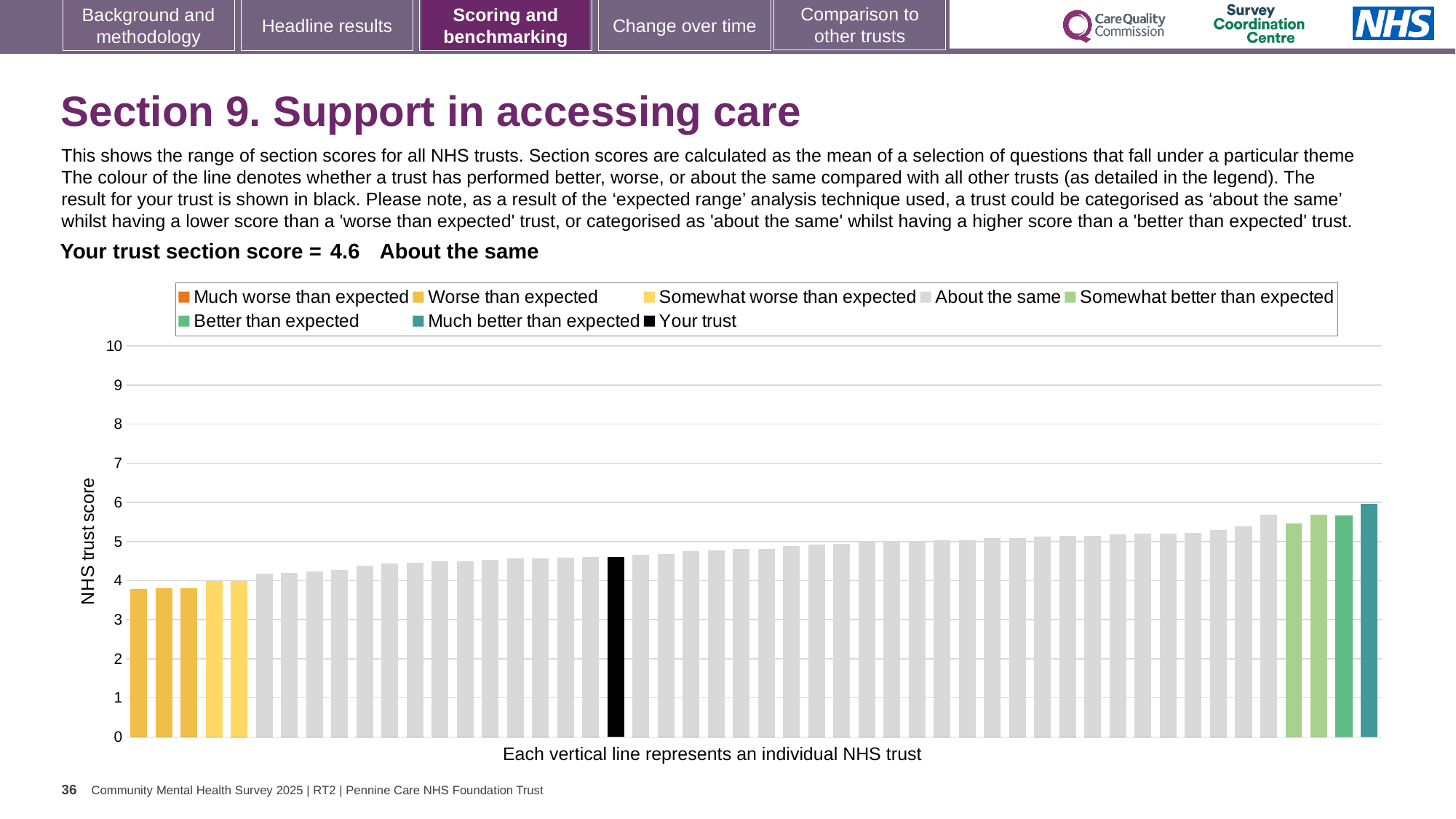
Is the value of the black 'Your trust' bar greater or less than 5? less Do the bar values rise or fall from left to right along the x axis? rise What is the label on the vertical axis of the chart? NHS trust score Which legend category does the tallest bar belong to? Much better than expected What kind of chart is shown on the slide? bar chart How many bars are coloured as 'Better than expected'? 1 Which category is your trust placed in according to the text above the chart? About the same How many entries does the chart legend list? 8 Is the value of the tallest bar greater or less than 5? greater What is the section score for your trust shown on the slide? 4.6 How many bars are coloured as 'Much better than expected'? 1 Is the value of the tallest bar greater or less than 7? less